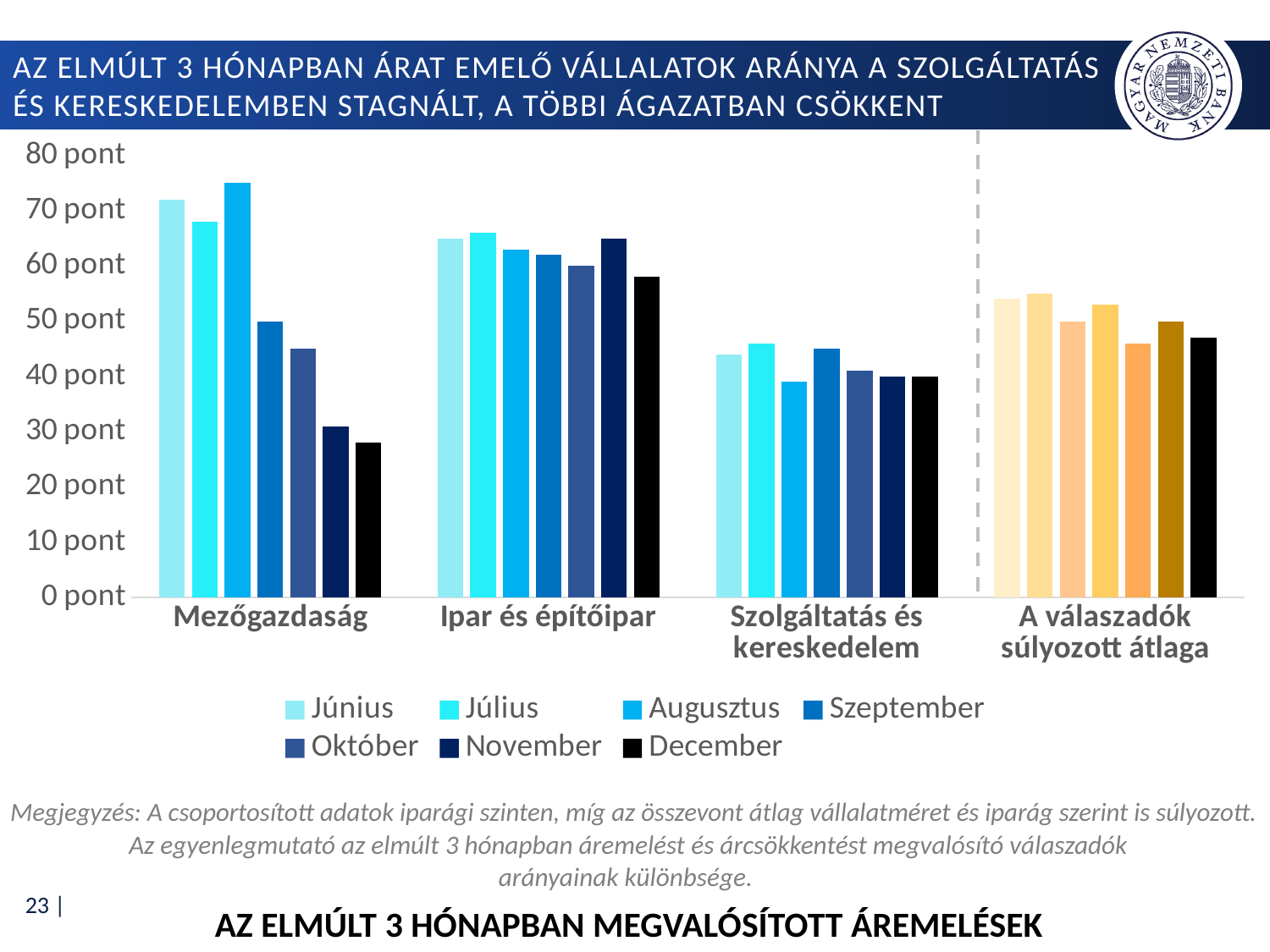
Is the November value for Mezőgazdaság greater or less than 40 pont? less Which month has the highest bar in the Mezőgazdaság category? Augusztus What kind of chart is shown on the slide? bar chart From Szeptember to December, do the values for Mezőgazdaság rise or fall? fall Is the Július value for Szolgáltatás és kereskedelem greater or less than 50 pont? less Which month has the lowest bar in the Mezőgazdaság category? December Which is larger: the Június value for Mezőgazdaság or the Június value for Szolgáltatás és kereskedelem? Mezőgazdaság How many series does the legend list? 7 Is the Augusztus value for Mezőgazdaság greater or less than 70 pont? greater How many categories are shown on the x axis of the chart? 4 Which category has the highest December bar? Ipar és építőipar